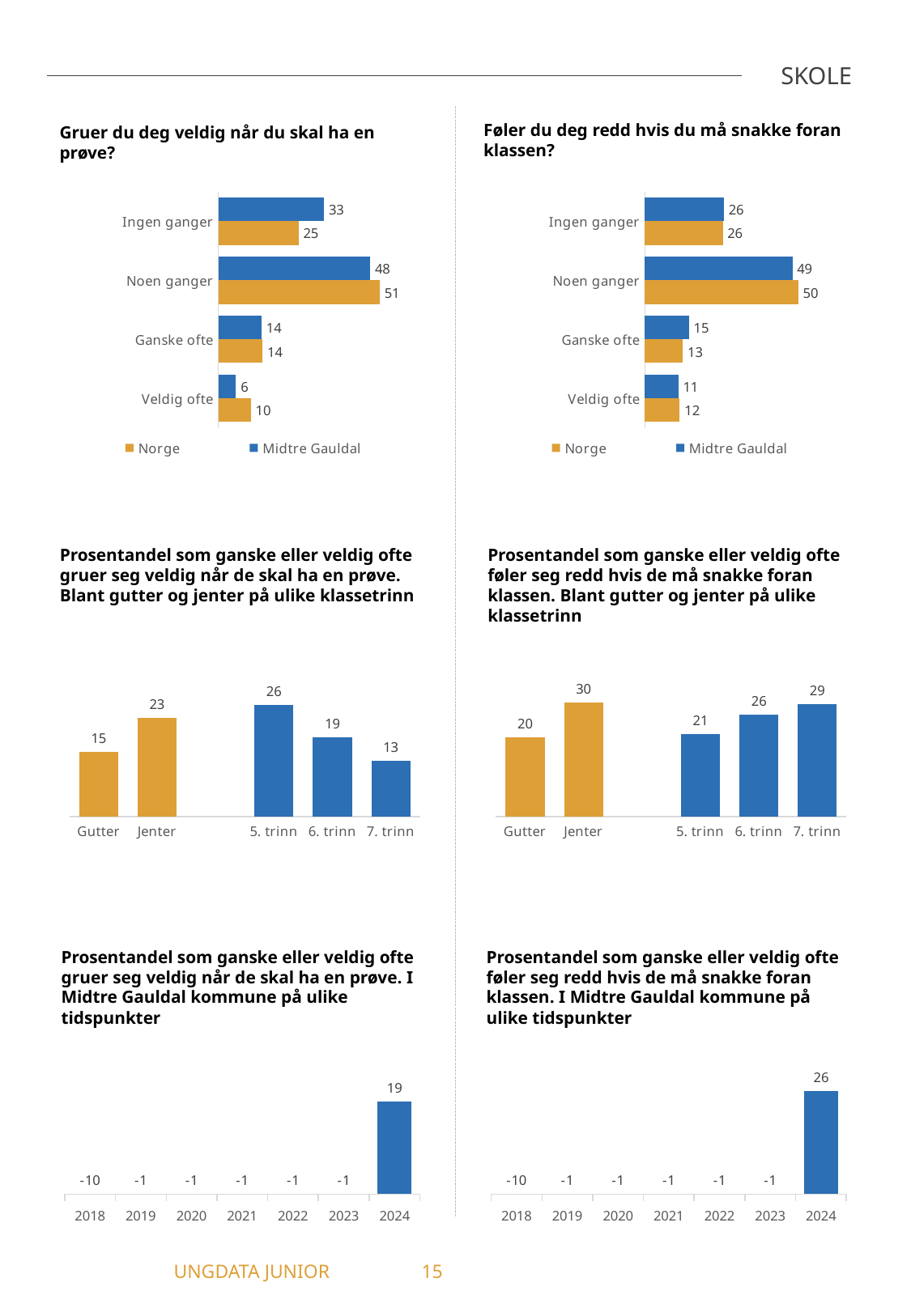
How many series does the legend list in the chart 'Føler du deg redd hvis du må snakke foran klassen?' 2 In the chart 'Føler du deg redd hvis du må snakke foran klassen?', what is the value for Norge in the 'Ganske ofte' category? 13 In the middle-right chart (prosentandel som føler seg redd hvis de må snakke foran klassen), what is the difference between Jenter and Gutter? 10 In the chart 'Gruer du deg veldig når du skal ha en prøve?', which category has the highest value for Norge? Noen ganger In the chart 'Gruer du deg veldig når du skal ha en prøve?', what is the difference between Norge and Midtre Gauldal for 'Veldig ofte'? 4 In the chart 'Føler du deg redd hvis du må snakke foran klassen?', which is larger for 'Veldig ofte': Norge or Midtre Gauldal? Norge In the bottom-right chart (prosentandel som føler seg redd hvis de må snakke foran klassen, i Midtre Gauldal kommune på ulike tidspunkter), what is the value for 2024? 26 In the chart 'Gruer du deg veldig når du skal ha en prøve?', what is the value for Midtre Gauldal in the 'Ingen ganger' category? 33 What kind of chart is 'Gruer du deg veldig når du skal ha en prøve?' Bar chart In the middle-right chart (prosentandel som føler seg redd hvis de må snakke foran klassen, blant gutter og jenter på ulike klassetrinn), how many categories are shown? 5 In the middle-left chart (prosentandel som gruer seg veldig når de skal ha en prøve), what is the value for Jenter? 23 In the middle-left chart (prosentandel som gruer seg veldig når de skal ha en prøve, blant gutter og jenter på ulike klassetrinn), which category has the lowest value? 7. trinn